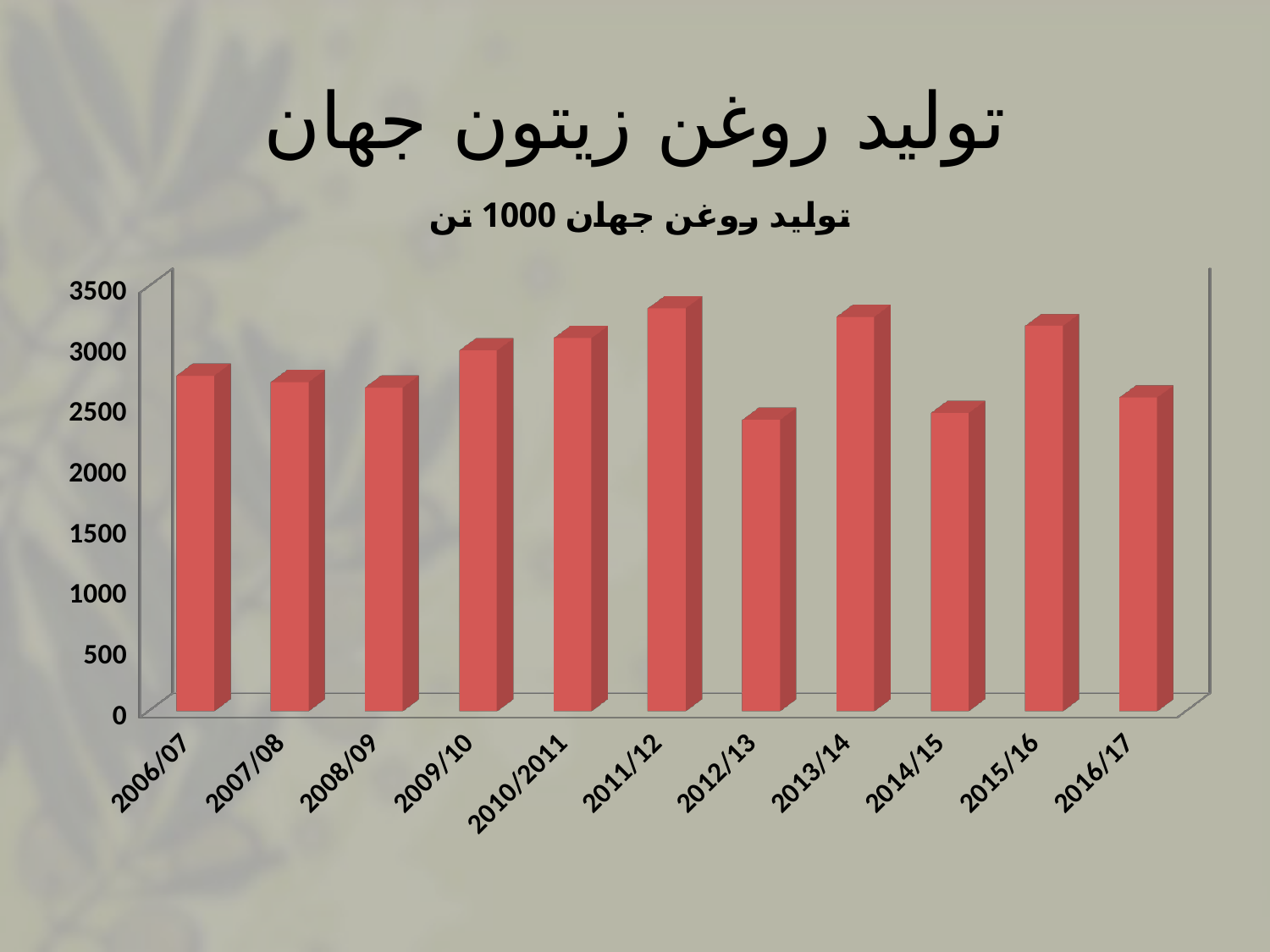
Is the value for 2013/14 greater or less than 3000? greater Which is larger, the value for 2011/12 or the value for 2012/13? 2011/12 What kind of chart is shown on the slide? bar chart Is the value for 2012/13 greater or less than 2500? less How many seasons (categories) are plotted on the x axis? 11 From 2008/09 to 2011/12, do the values rise or fall? rise Which season has the highest bar? 2011/12 Is the value for 2011/12 greater or less than 3000? greater What is the title printed above the chart? تولید روغن جهان 1000 تن Which is larger, the value for 2013/14 or the value for 2014/15? 2013/14